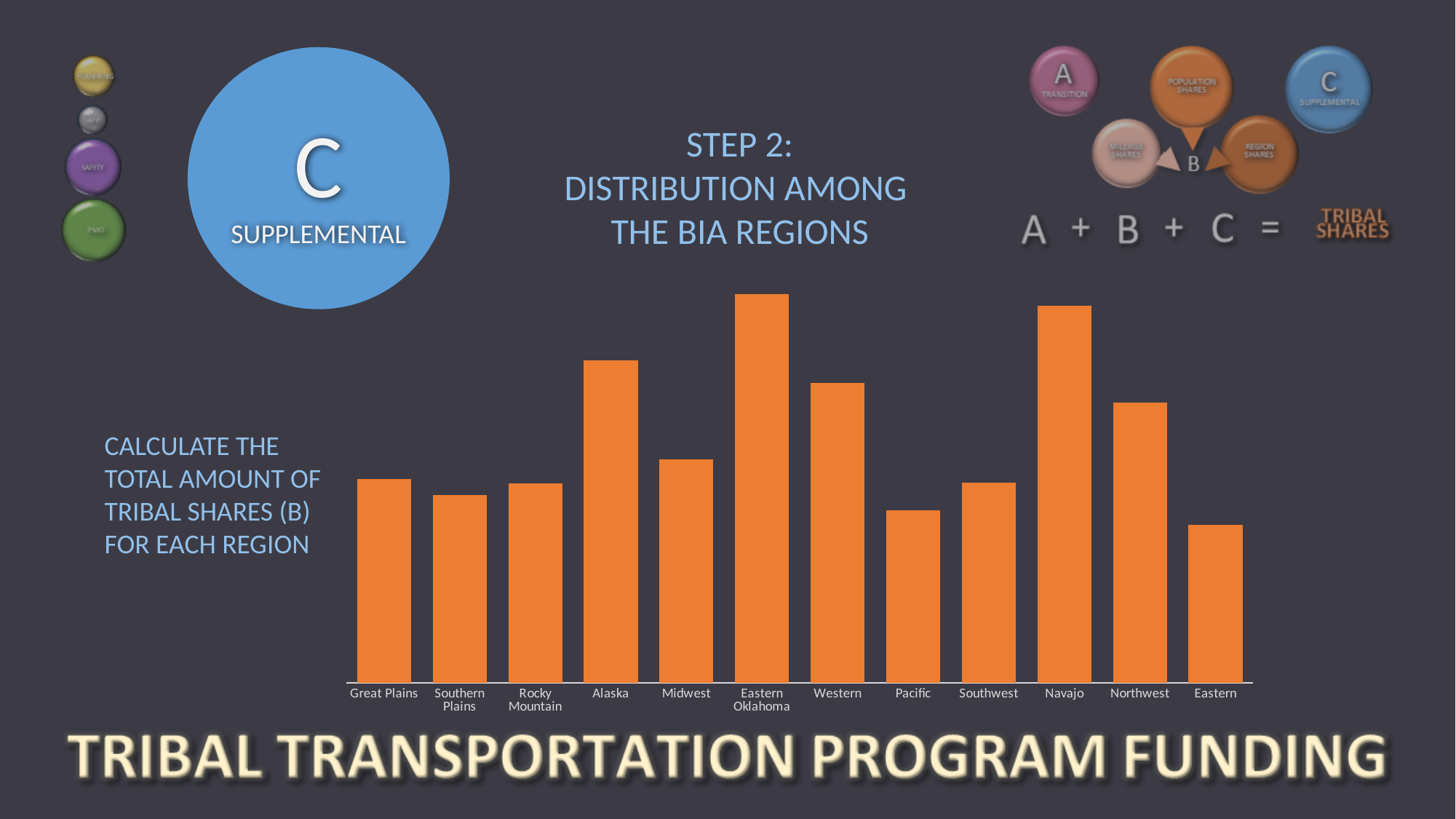
Which bar is taller, Pacific or Southwest? Southwest How many BIA regions are shown on the x axis of the bar chart? 12 Which bar is taller, Midwest or Great Plains? Midwest Which bar is taller, Alaska or Western? Alaska What kind of chart is shown on the slide? bar chart Which region has the shortest bar in the chart? Eastern Which region has the second tallest bar in the chart? Navajo Which region has the tallest bar in the chart? Eastern Oklahoma What colour are the bars in the chart? orange Which region's label appears first on the left of the x axis? Great Plains